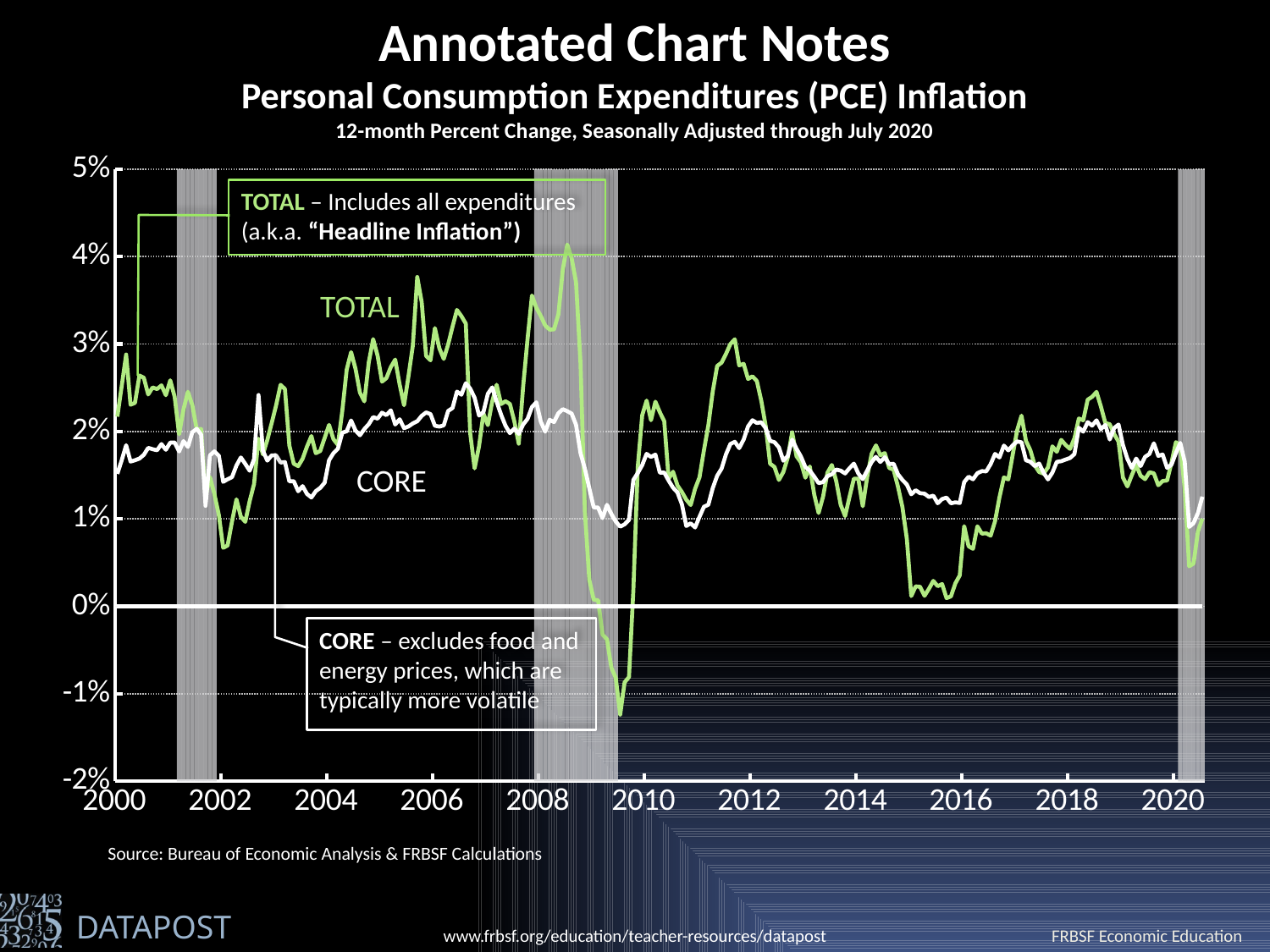
Is the value of the CORE line in 2010 greater or less than 0%? greater Is the lowest value of the TOTAL line around 2009 greater or less than 0%? less Does the CORE line ever rise above 3% on the chart? No Which series is drawn in green, TOTAL or CORE? TOTAL How many data series are plotted on the chart? 2 Which line is higher at its 2008 peak, TOTAL or CORE? TOTAL What kind of chart is shown on the slide? line chart Does the TOTAL line rise or fall between its 2008 peak and 2009? fall What is the chart's subtitle describing the measure and period? 12-month Percent Change, Seasonally Adjusted through July 2020 Which line is lower during 2015, TOTAL or CORE? TOTAL